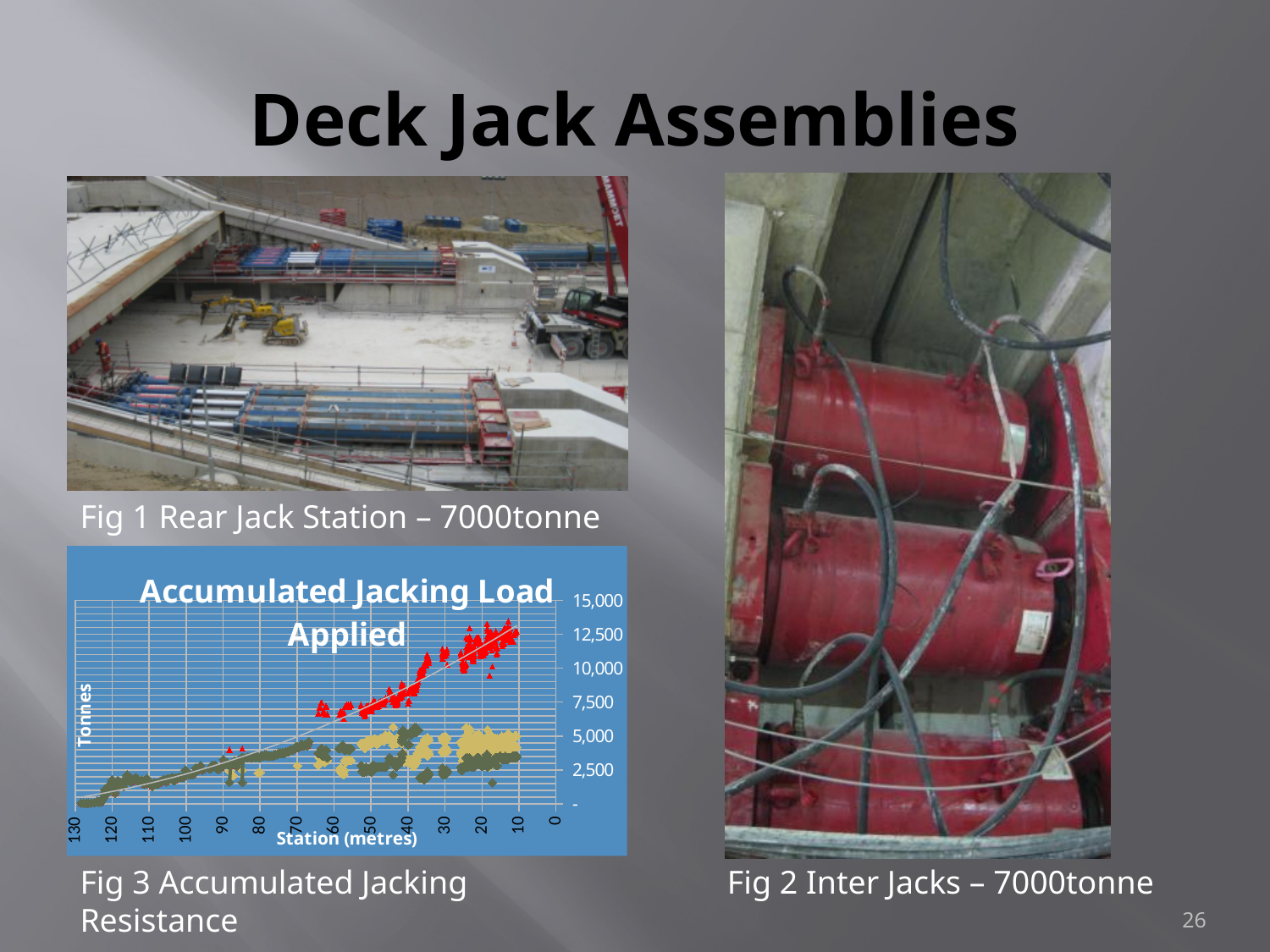
In the "Accumulated Jacking Load Applied" chart, are the red triangle values near station 20 greater or less than 10,000 tonnes? greater What is the highest value shown on the y axis of the "Accumulated Jacking Load Applied" chart? 15,000 In the "Accumulated Jacking Load Applied" chart, are the values near station 120 greater or less than 2,500 tonnes? less In the "Accumulated Jacking Load Applied" chart, do the red triangle values rise or fall as the station decreases from 130 to 0 metres? rise What is the label of the x axis of the "Accumulated Jacking Load Applied" chart? Station (metres) What kind of chart is the "Accumulated Jacking Load Applied" chart? scatter chart In the "Accumulated Jacking Load Applied" chart, near station 20, which series has the larger values: the red triangles or the olive diamonds? red triangles What is the title of the chart on the slide? Accumulated Jacking Load Applied In the "Accumulated Jacking Load Applied" chart, are the olive diamond values near station 20 greater or less than 7,500 tonnes? less